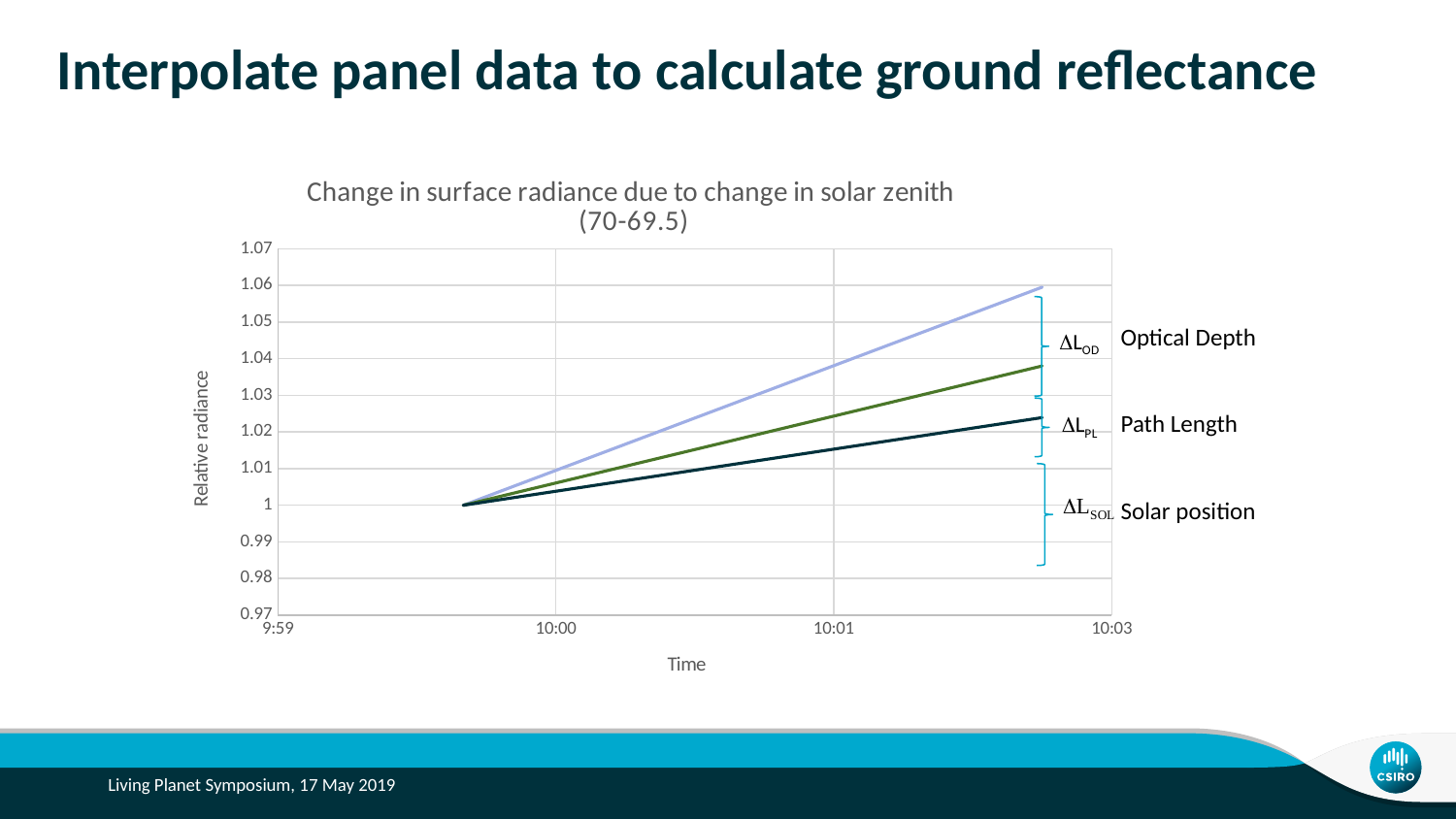
What is the title of the chart? Change in surface radiance due to change in solar zenith (70-69.5) At what relative radiance value do all three lines start? 1 What kind of chart is shown on the slide? line chart What is the label of the y axis? Relative radiance How many lines are plotted on the chart? 3 Do the lines rise or fall as time increases along the x axis? rise